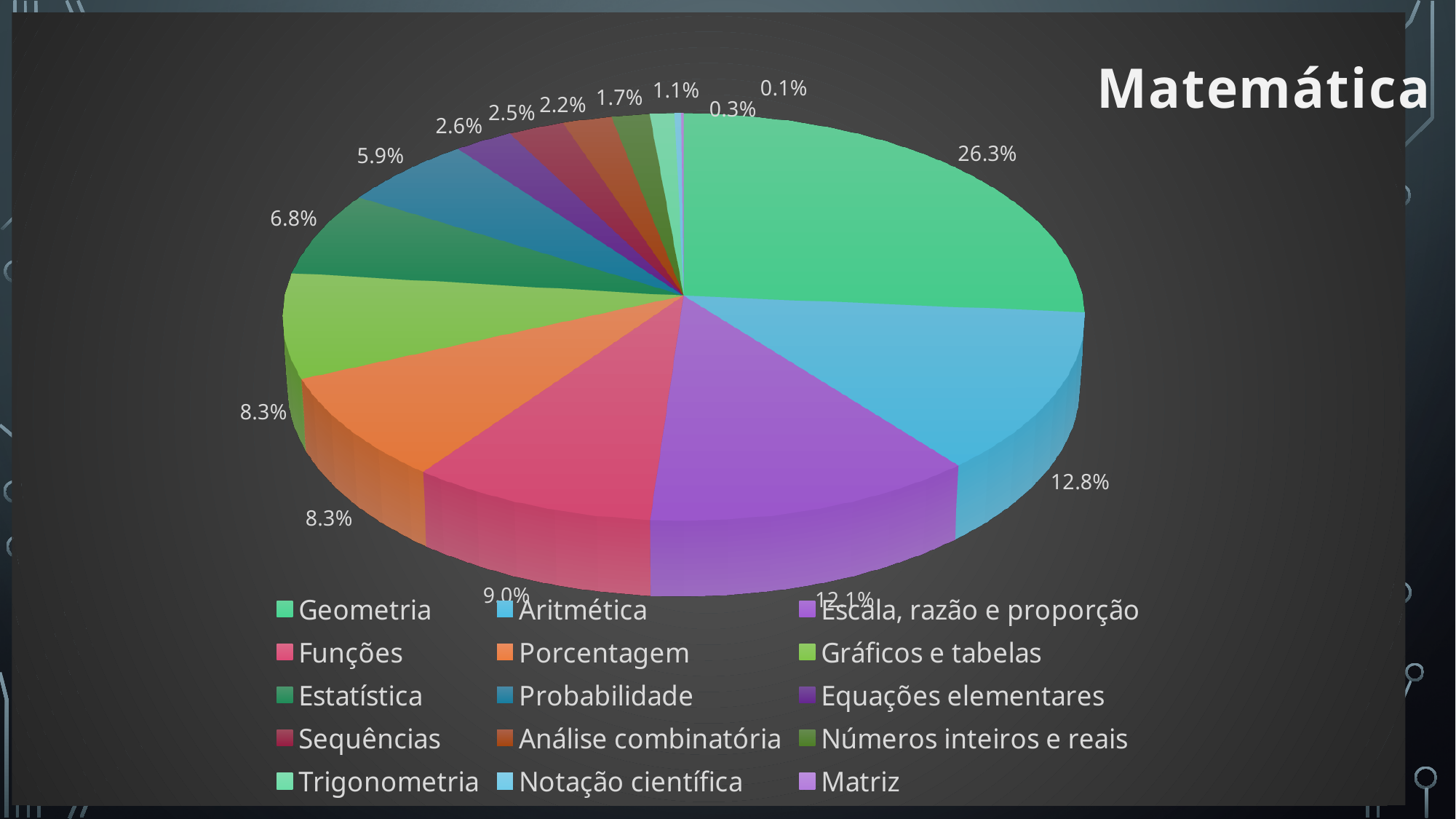
What percentage does the Geometria slice represent? 26.3% Which category has the smallest share of the pie? Matriz What is the combined share of Porcentagem and Gráficos e tabelas? 16.6% What is the title of the chart? Matemática How many categories does the legend list? 15 Which is larger, the share for Funções or the share for Porcentagem? Funções Which category has the largest share of the pie? Geometria What type of chart is shown on the slide? pie chart What percentage does the Probabilidade slice represent? 5.9% What is the difference in percentage points between Geometria and Aritmética? 13.5 What percentage does the Estatística slice represent? 6.8% What percentage does the Aritmética slice represent? 12.8%